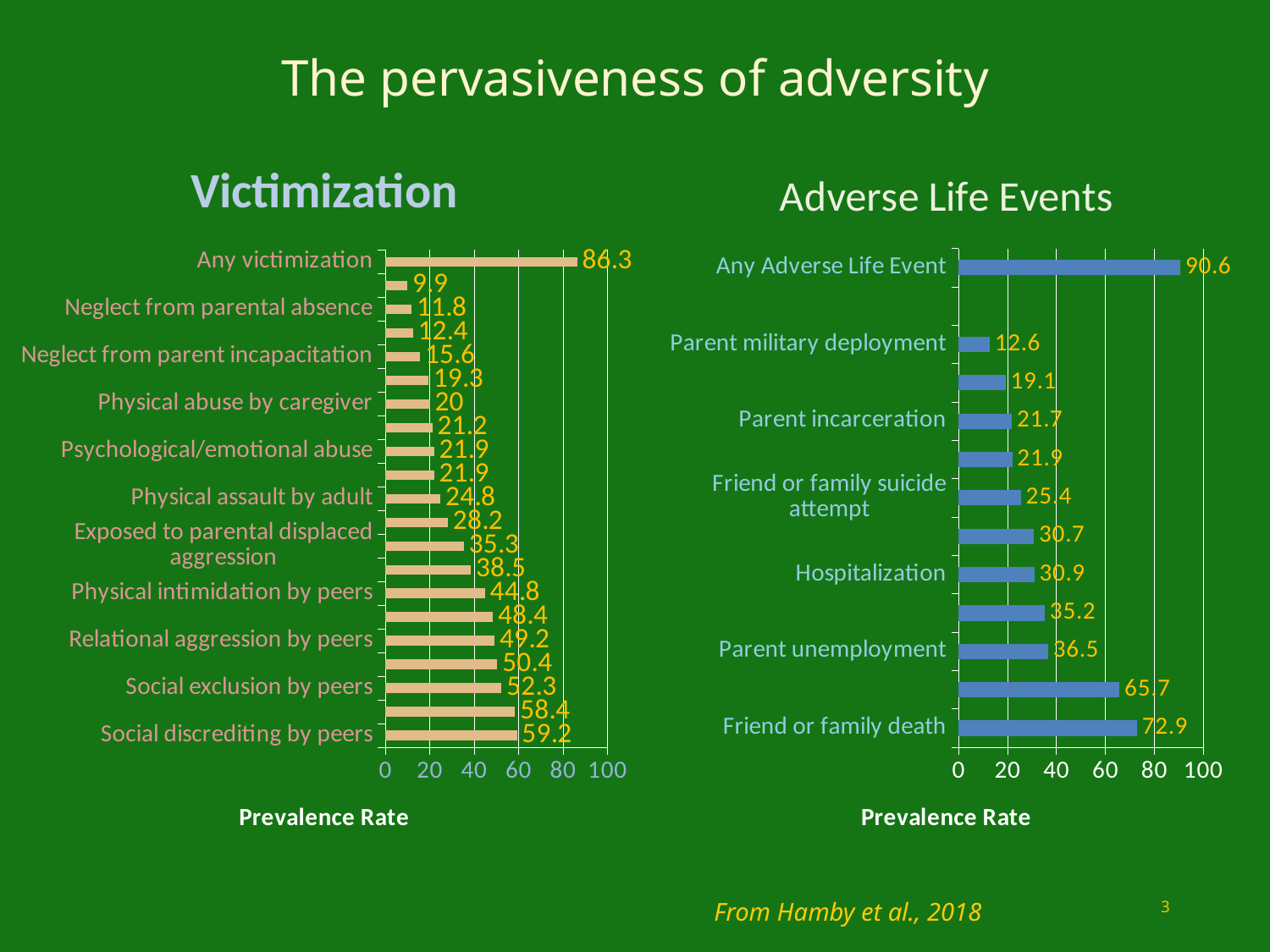
In the Victimization chart, which has a higher prevalence rate: Physical assault by adult or Relational aggression by peers? Relational aggression by peers In the Victimization chart, what is the prevalence rate for Any victimization? 86.3 How many bars are plotted in the Adverse Life Events chart? 12 In the Adverse Life Events chart, what is the difference between the prevalence rates for Any Adverse Life Event and Friend or family death? 17.7 What type of chart is the Victimization chart? Bar chart In the Adverse Life Events chart, which labelled category has the lowest prevalence rate? Parent military deployment In the Adverse Life Events chart, what is the prevalence rate for Hospitalization? 30.9 In the Adverse Life Events chart, which category has the highest prevalence rate? Any Adverse Life Event In the Victimization chart, what is the prevalence rate for Social discrediting by peers? 59.2 In the Victimization chart, what is the prevalence rate for Physical abuse by caregiver? 20 In the Adverse Life Events chart, is the value for Parent unemployment greater or less than 40? less In the Adverse Life Events chart, what is the prevalence rate for Friend or family death? 72.9